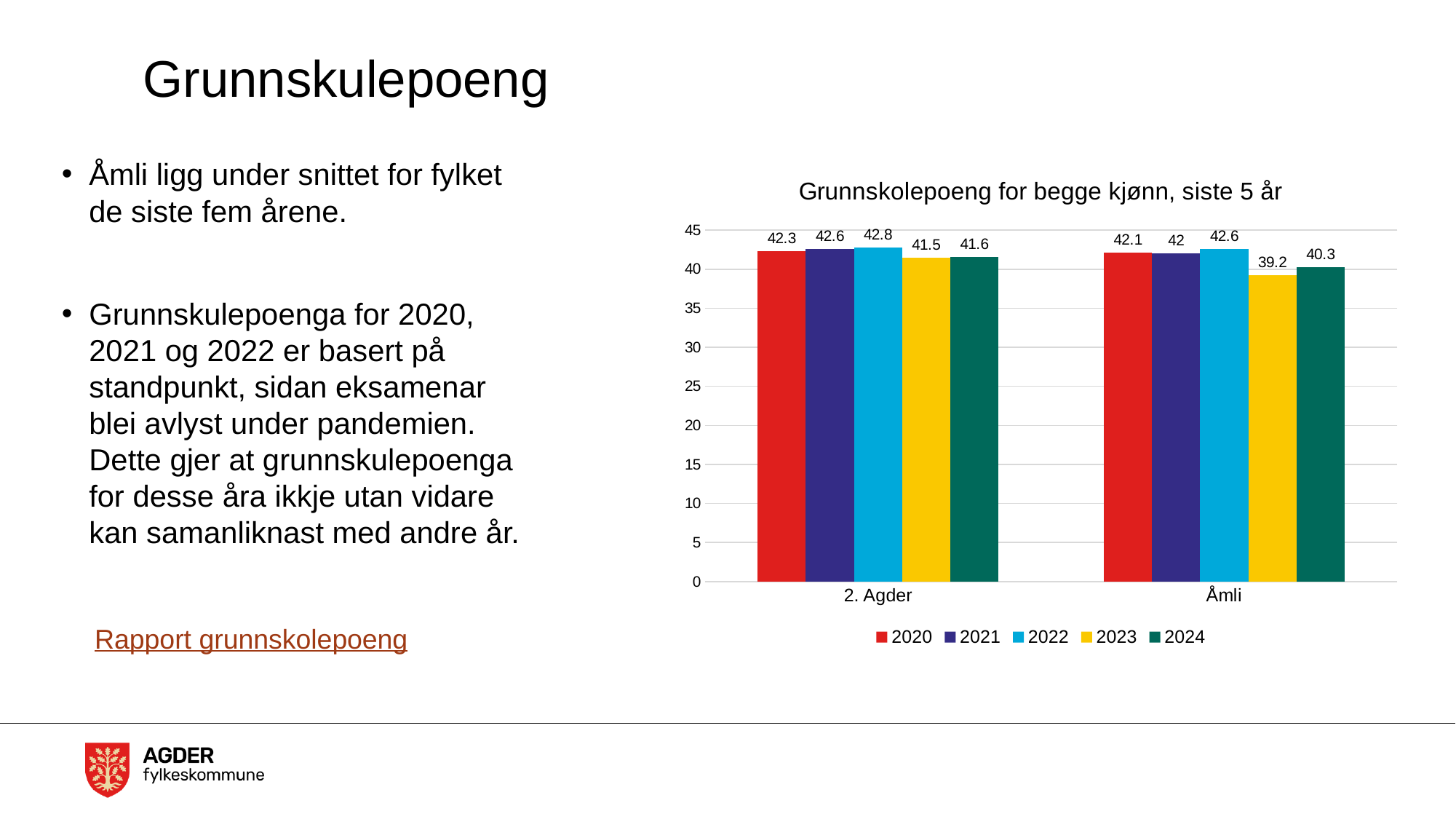
Which year has the highest value for 2. Agder? 2022 What is the difference between the 2022 and 2024 values for Åmli? 2.3 What is the difference between the 2023 values for 2. Agder and Åmli? 2.3 What is the value for Åmli in 2024? 40.3 What is the value for 2. Agder in 2020? 42.3 How many categories are shown on the x axis? 2 How many series does the legend list? 5 Which year has the lowest value for Åmli? 2023 What is the title of the chart? Grunnskolepoeng for begge kjønn, siste 5 år What is the value for 2. Agder in 2022? 42.8 What is the value for Åmli in 2023? 39.2 Which is larger: the 2024 value for 2. Agder or the 2024 value for Åmli? 2. Agder